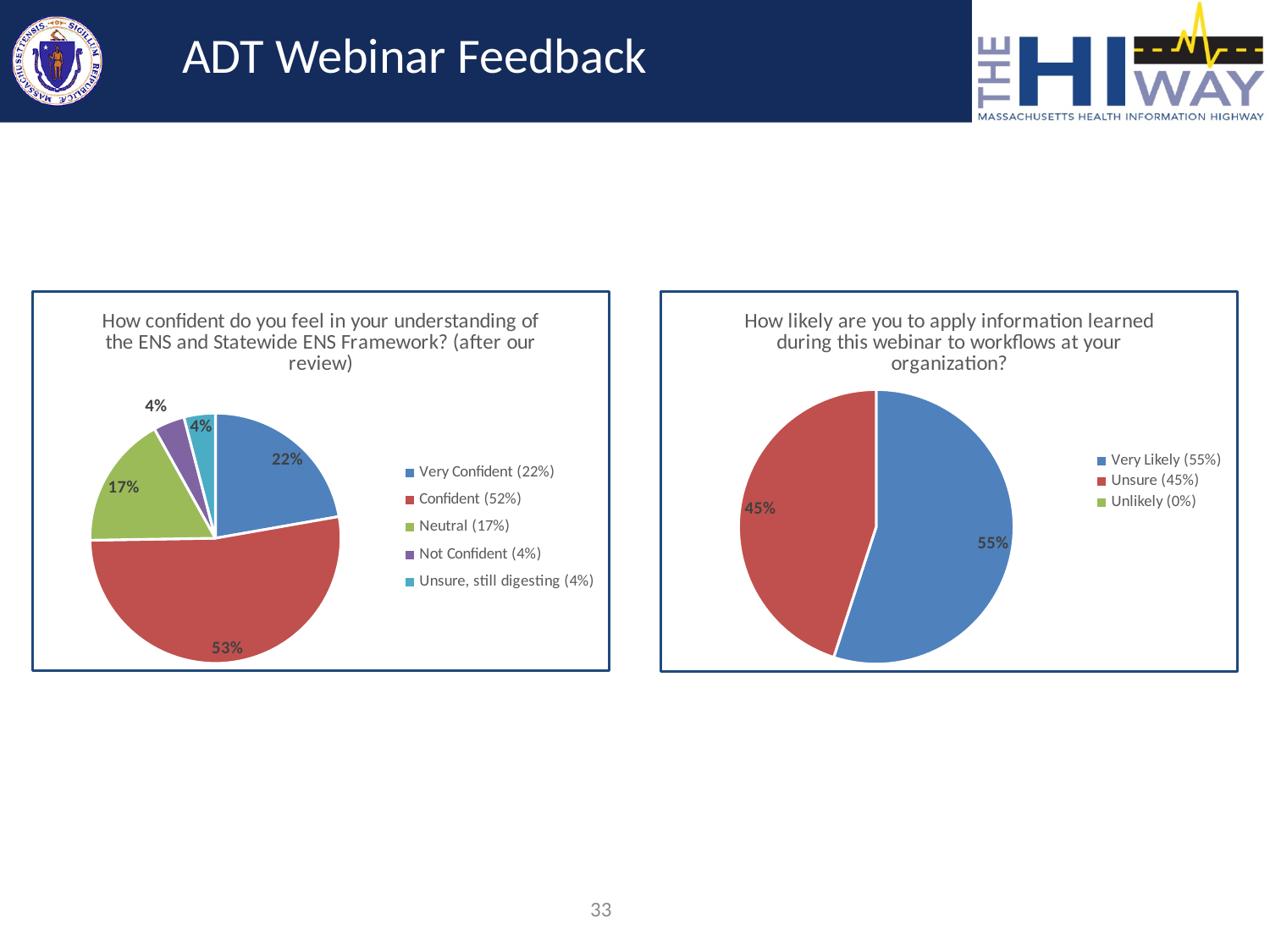
In the right chart on how likely respondents are to apply information learned, what percentage is shown for 'Unsure'? 45% What kind of chart is the left chart, titled 'How confident do you feel in your understanding of the ENS and Statewide ENS Framework?'? Pie chart In the left chart on confidence in understanding the ENS, how many categories does the legend list? 5 In the right chart on how likely respondents are to apply information learned, what percentage is shown for 'Very Likely'? 55% In the left chart on confidence in understanding the ENS, what percentage is shown on the 'Neutral' slice? 17% In the left chart on confidence in understanding the ENS, which slice is larger: 'Very Confident' or 'Neutral'? Very Confident In the left chart on confidence in understanding the ENS, what percentage is shown on the 'Very Confident' slice? 22% In the left chart on confidence in understanding the ENS, what is the difference between the 'Very Confident' and 'Neutral' slices? 5% In the right chart on how likely respondents are to apply information learned, what is the difference between the 'Very Likely' and 'Unsure' slices? 10% In the right chart on how likely respondents are to apply information learned, what colour is the 'Very Likely' slice? Blue In the left chart on confidence in understanding the ENS, which category has the largest slice? Confident In the right chart on how likely respondents are to apply information learned, what percentage does the legend give for 'Unlikely'? 0%